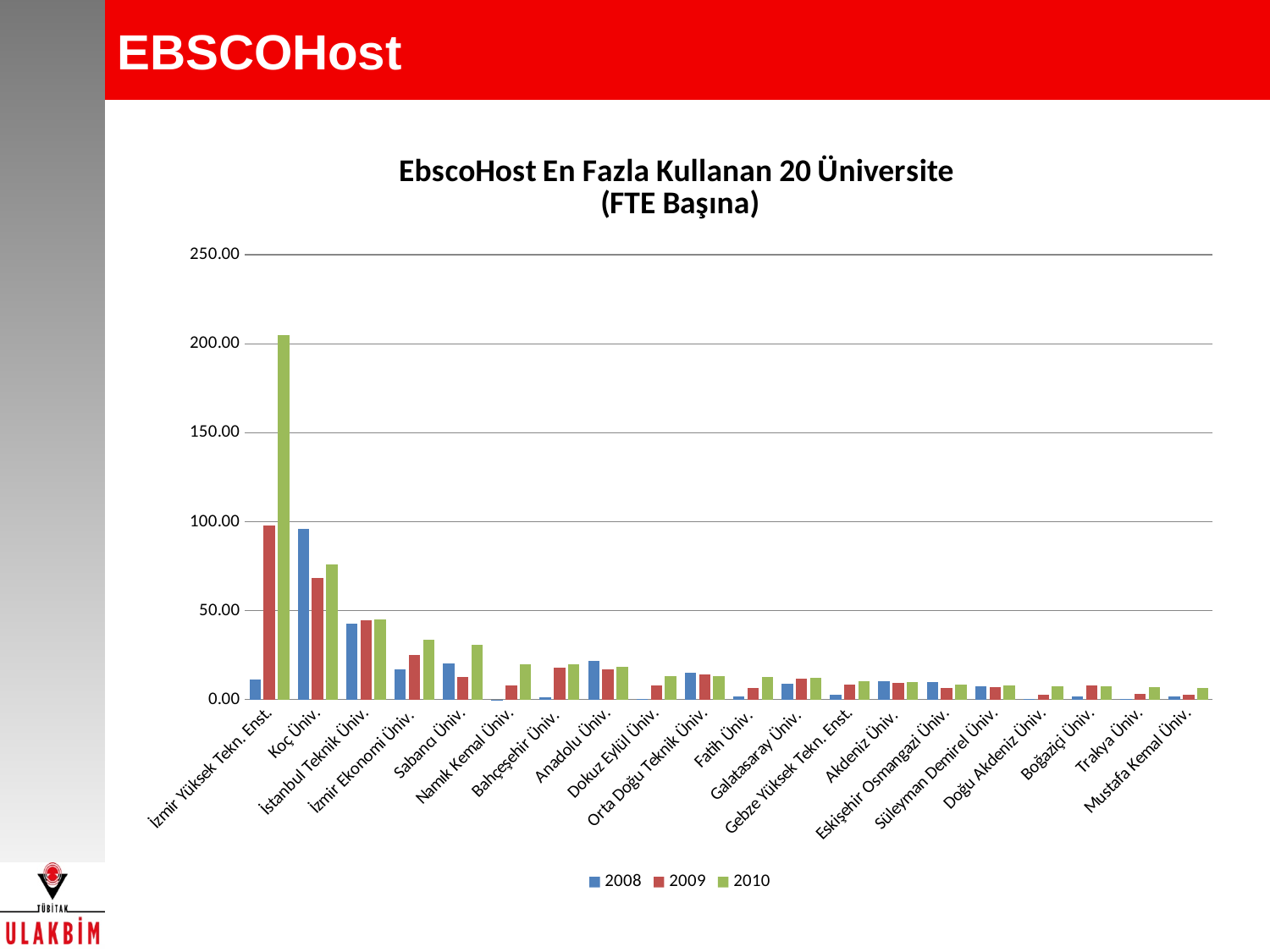
Which year is represented by the green bars in the legend? 2010 Is the 2008 value for Koç Üniv. greater or less than 100? less Is the 2010 value for İzmir Yüksek Tekn. Enst. greater or less than 200? greater Is the 2010 value for İstanbul Teknik Üniv. greater or less than 50? less How many universities are shown on the x axis? 20 For İzmir Ekonomi Üniv., which is larger, the 2009 value or the 2010 value? 2010 What is the title of the chart? EbscoHost En Fazla Kullanan 20 Üniversite (FTE Başına) Which university has the highest 2008 value? Koç Üniv. How many series does the legend list? 3 Which university has the highest 2010 value? İzmir Yüksek Tekn. Enst. For Koç Üniv., which is larger, the 2008 value or the 2009 value? 2008 What kind of chart is shown on the slide? bar chart